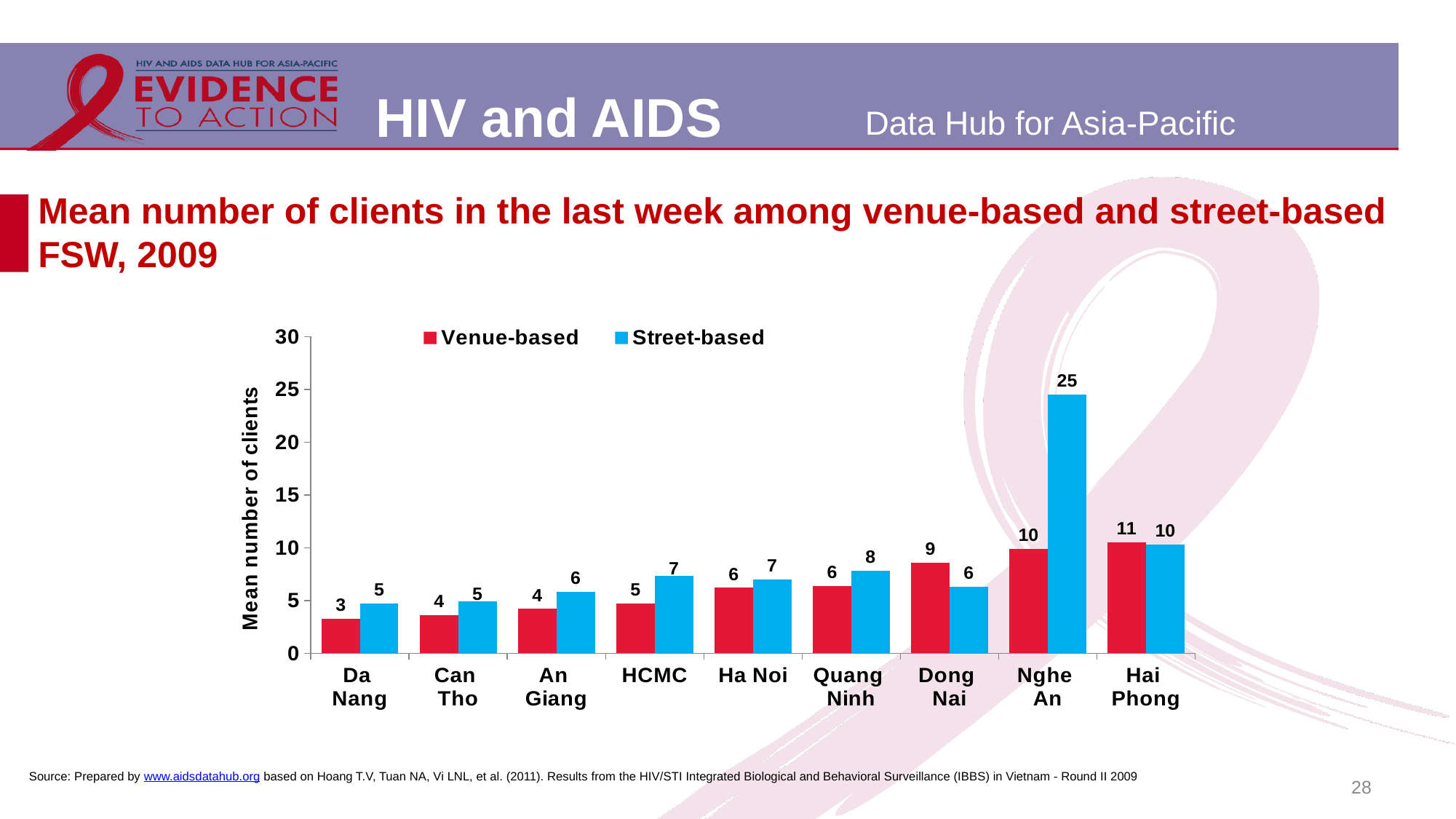
In Nghe An, what is the difference between the street-based and venue-based mean number of clients? 15 Which province has the highest mean number of clients among venue-based FSW? Hai Phong Which province has the lowest mean number of clients among venue-based FSW? Da Nang How many provinces are shown on the x axis? 9 What is the mean number of clients for street-based FSW in Quang Ninh? 8 Which province has the highest mean number of clients among street-based FSW? Nghe An What kind of chart is shown on the slide? Bar chart Is the street-based value for Nghe An greater or less than 20? greater In Dong Nai, which group has the larger mean number of clients, venue-based or street-based? Venue-based How many series does the legend list? 2 What is the mean number of clients for venue-based FSW in Dong Nai? 9 What is the mean number of clients for street-based FSW in Nghe An? 25